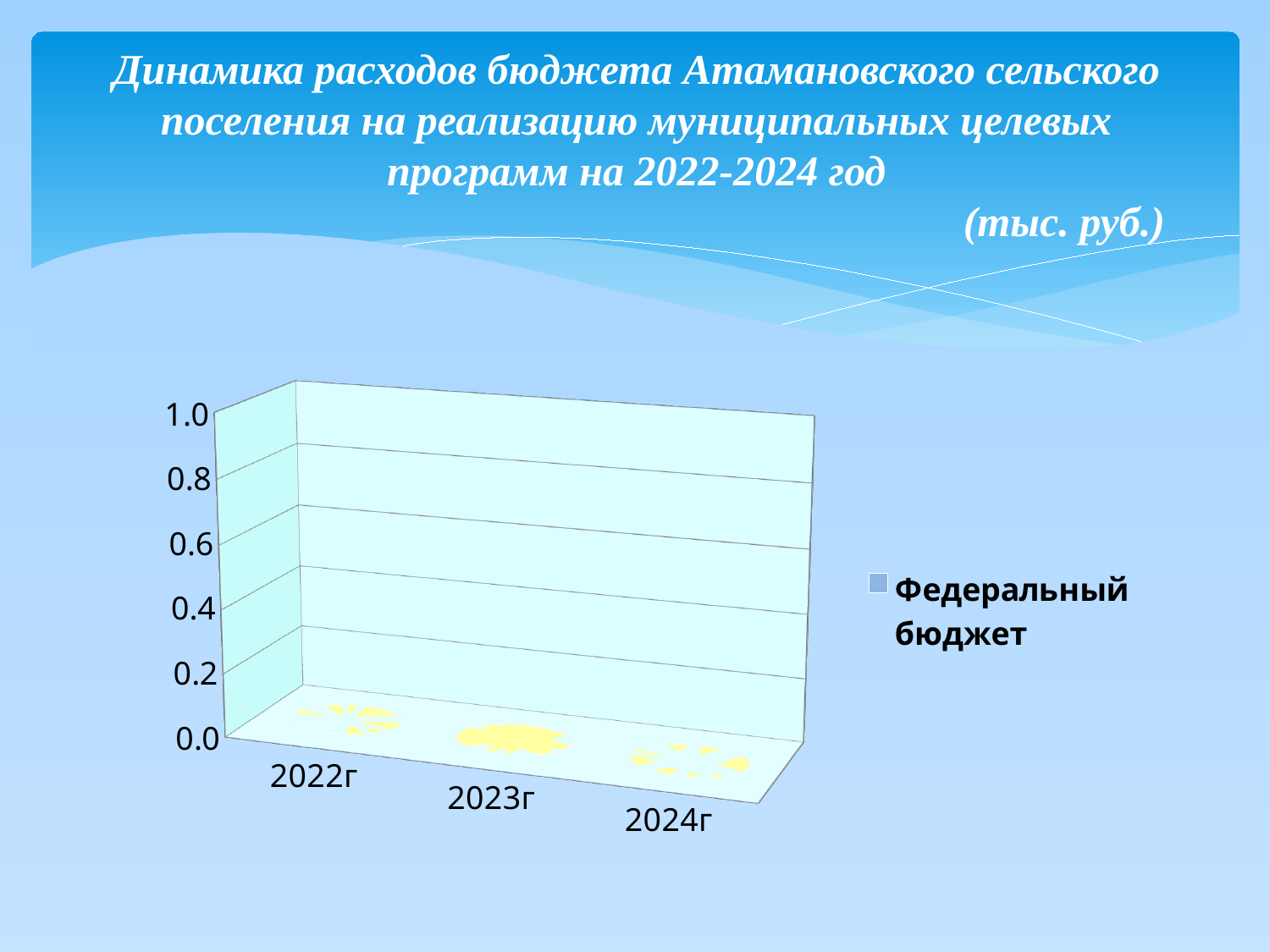
What kind of chart is shown on the slide? bar chart Is the value for 2022г greater or less than 0.2? less What is the highest value shown on the chart's vertical axis? 1.0 How many series does the chart's legend list? 1 How many categories are shown on the x axis of the chart? 3 Is the value for 2024г greater or less than 0.4? less What is the name of the series listed in the chart's legend? Федеральный бюджет Which years are shown as categories on the x axis of the chart? 2022г, 2023г, 2024г Is the value for 2023г greater or less than 0.2? less